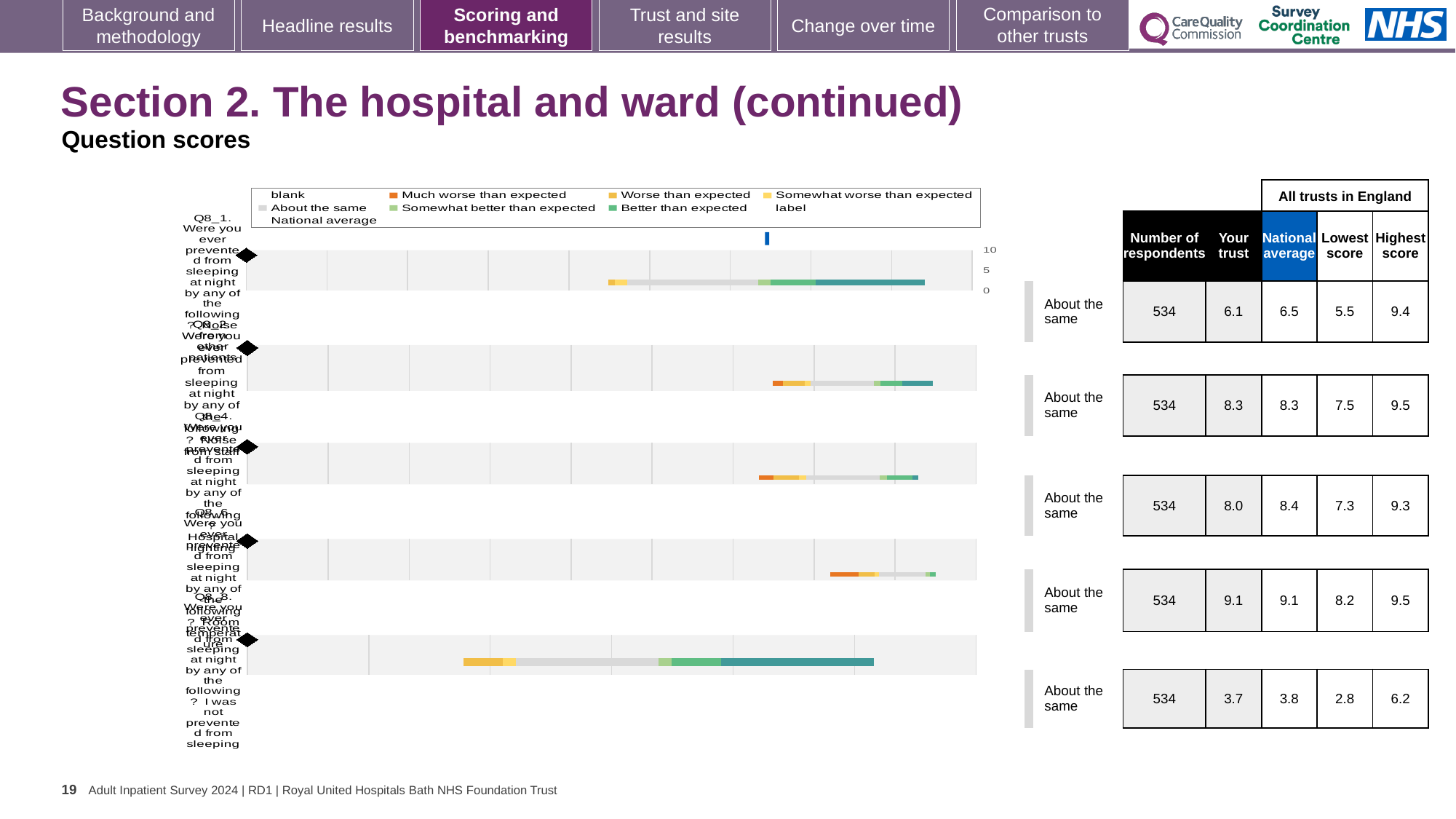
For the fifth (bottom) row, what is the difference between the highest score (6.2) and the lowest score (2.8)? 3.4 What type of chart is shown on the slide? bar chart How many question rows (bars) are plotted in the chart? 5 For the third row, what is the difference between the national average (8.4) and the 'Your trust' score (8.0)? 0.4 According to the table, what is the 'Your trust' score for the first (top) row, Q8_1? 6.1 According to the table, what is the national average for the second row? 8.3 According to the table, what is the highest score in England for the fifth (bottom) row? 6.2 Which row has the lowest 'Your trust' score in the table? the fifth (bottom) row (3.7) Which row has the highest 'Your trust' score in the table? the fourth row (9.1) For the first row, Q8_1, which is larger: the 'Your trust' score or the national average? the national average (6.5) What benchmark category is shown next to every bar in the chart? About the same How many respondents are listed for each question in the table? 534